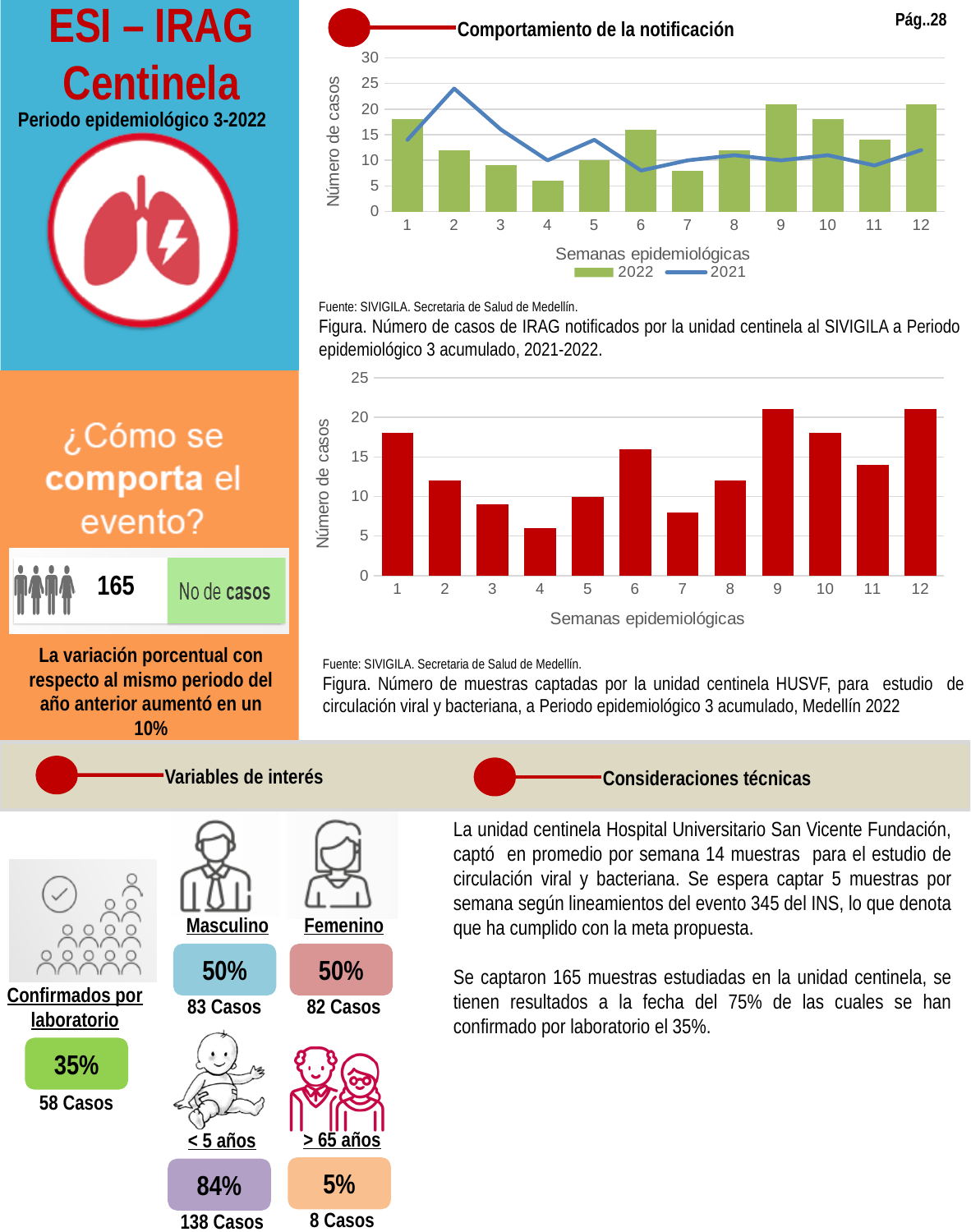
What kind of chart is the bottom chart (Número de muestras captadas)? bar chart In the top chart (Comportamiento de la notificación), in week 1, which series has the larger value, 2022 or 2021? 2022 In the top chart (Comportamiento de la notificación), how many epidemiological weeks are shown on the x axis? 12 In the top chart (Comportamiento de la notificación), is the 2022 value for week 9 greater or less than 15? greater In the top chart (Comportamiento de la notificación), which week has the lowest 2022 bar? 4 In the bottom chart (Número de muestras captadas), is the value for week 7 greater or less than 10? less In the top chart (Comportamiento de la notificación), in which week does the 2021 line reach its highest value? 2 In the bottom chart (Número de muestras captadas), do the values rise or fall from week 1 to week 4? fall In the bottom chart (Número de muestras captadas), which week has the lowest value? 4 In the top chart (Comportamiento de la notificación), how many series does the legend list? 2 In the top chart (Comportamiento de la notificación), what are the legend entries? 2022 and 2021 In the top chart (Comportamiento de la notificación), in week 2, which series has the larger value, 2022 or 2021? 2021